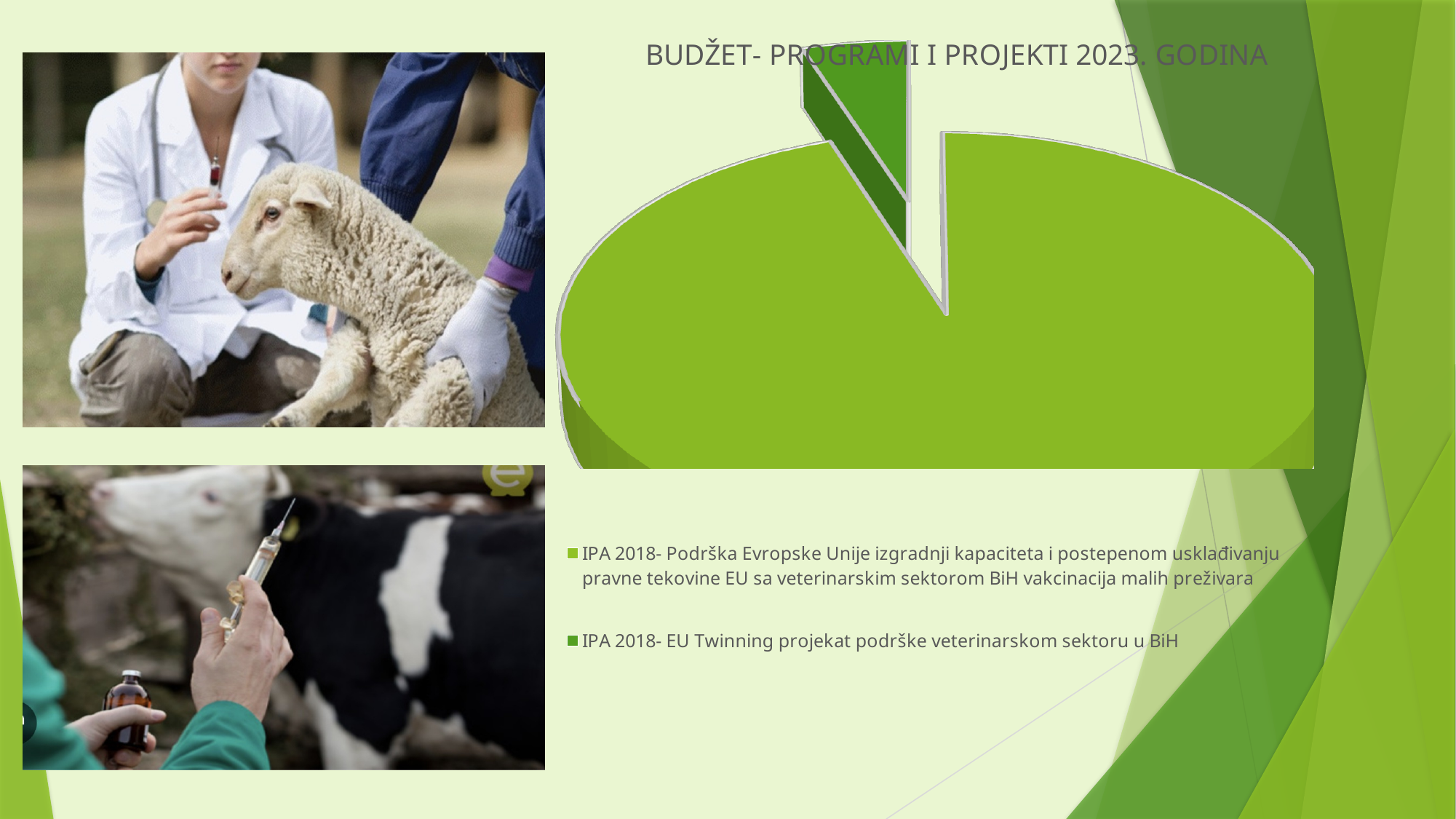
What kind of chart is shown on the slide? Pie chart How many entries does the legend of the pie chart list? 2 Which category has the largest slice in the pie chart? IPA 2018- Podrška Evropske Unije izgradnji kapaciteta i postepenom usklađivanju pravne tekovine EU sa veterinarskim sektorom BiH vakcinacija malih preživara How many slices does the pie chart have? 2 What is the title of the chart on the slide? BUDŽET- PROGRAMI I PROJEKTI 2023. GODINA Which category has the smallest slice in the pie chart? IPA 2018- EU Twinning projekat podrške veterinarskom sektoru u BiH Which colour represents the IPA 2018- EU Twinning projekat podrške veterinarskom sektoru u BiH slice? Dark green Which slice is larger: the one for the EU Twinning projekat or the one for the vakcinacija malih preživara programme? Vakcinacija malih preživara programme